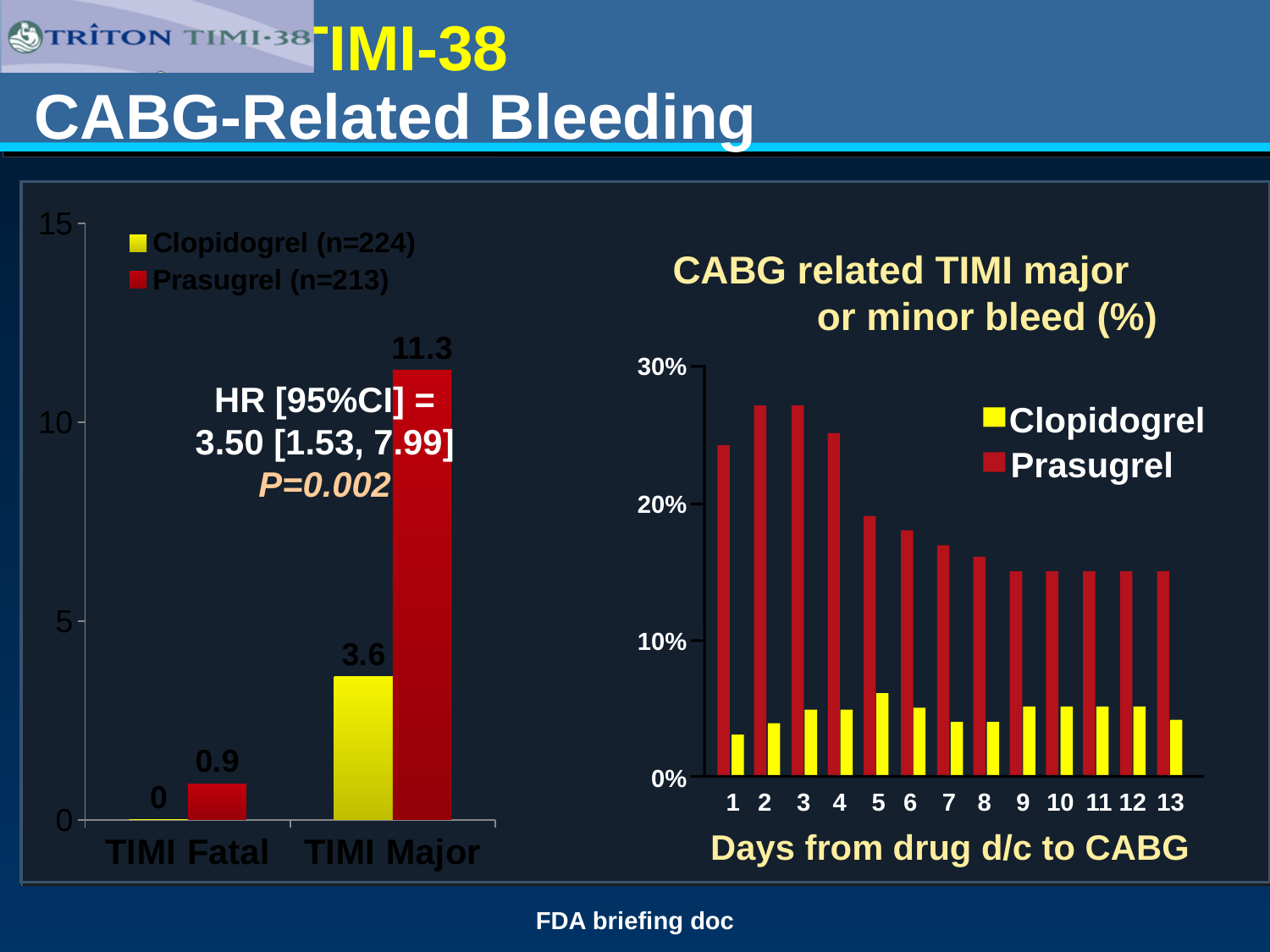
In the left chart, what is the value for Prasugrel in the TIMI Fatal category? 0.9 In the left chart, what is the value for Clopidogrel in the TIMI Major category? 3.6 In the left chart, how many series does the legend list? 2 In the left chart, what is the difference between the Prasugrel and Clopidogrel values for TIMI Major? 7.7 What kind of chart is the chart titled 'CABG related TIMI major or minor bleed (%)'? Bar chart In the chart titled 'CABG related TIMI major or minor bleed (%)', is the Prasugrel value at day 2 greater or less than 20%? greater In the left chart, what is the sample size (n) shown for Clopidogrel in the legend? 224 In the chart titled 'CABG related TIMI major or minor bleed (%)', is the Clopidogrel value at day 5 greater or less than 10%? less In the left chart, what is the value for Prasugrel in the TIMI Major category? 11.3 In the chart titled 'CABG related TIMI major or minor bleed (%)', how many days are shown on the x axis? 13 In the left chart, what is the value for Clopidogrel in the TIMI Fatal category? 0 In the left chart, which series has the larger value for TIMI Major, Clopidogrel or Prasugrel? Prasugrel